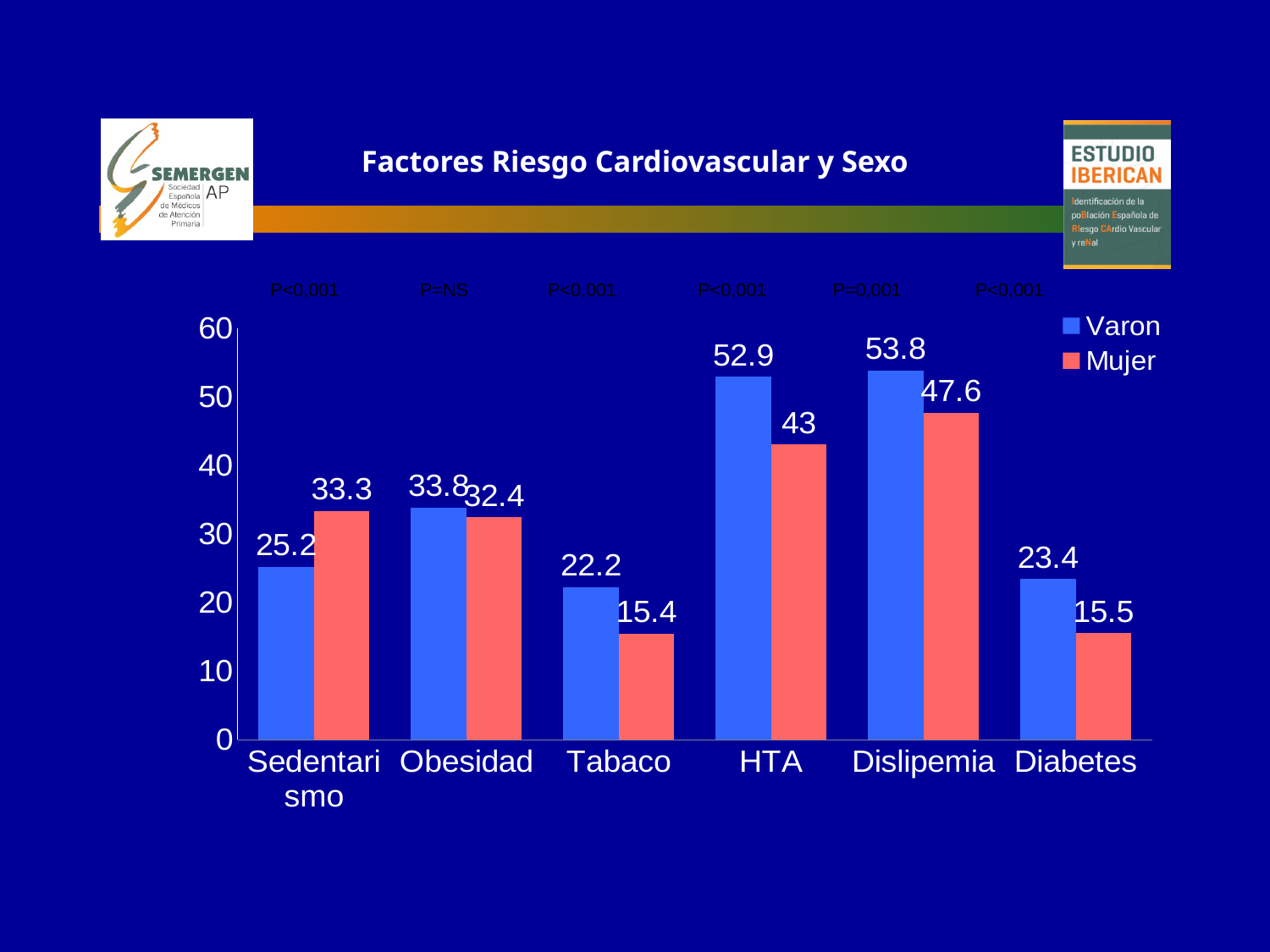
What kind of chart is shown on the slide? bar chart Which category has the highest Varon value? Dislipemia What is the title of the chart? Factores Riesgo Cardiovascular y Sexo What is the value for Varon in the HTA category? 52.9 What is the difference between the Varon and Mujer values for Dislipemia? 6.2 How many categories are shown on the x axis? 6 How many series does the legend list? 2 What is the difference between the Varon and Mujer values for Tabaco? 6.8 What is the value for Mujer in the Diabetes category? 15.5 What is the value for Mujer in the Sedentarismo category? 33.3 Which is larger in the Sedentarismo category, Varon or Mujer? Mujer Which category has the lowest Mujer value? Tabaco